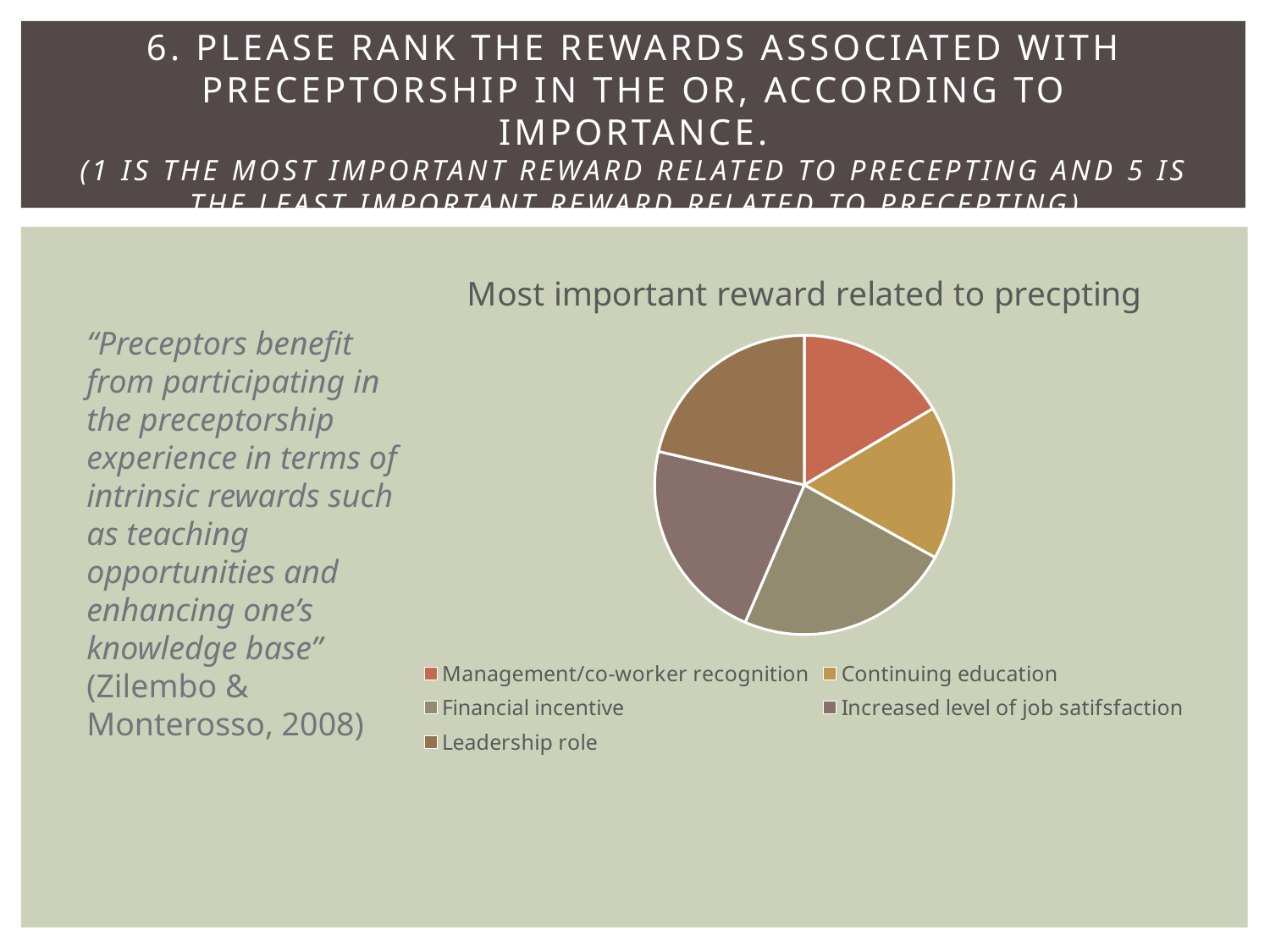
Which slice is larger in the pie chart: Financial incentive or Management/co-worker recognition? Financial incentive What kind of chart is shown on the slide? pie chart Which slice is larger in the pie chart: Leadership role or Continuing education? Leadership role How many slices does the pie chart have? 5 How many entries does the legend of the pie chart list? 5 Which legend entry in the pie chart is shown in red? Management/co-worker recognition What is the title of the pie chart? Most important reward related to precpting Which slice is larger in the pie chart: Increased level of job satifsfaction or Management/co-worker recognition? Increased level of job satifsfaction